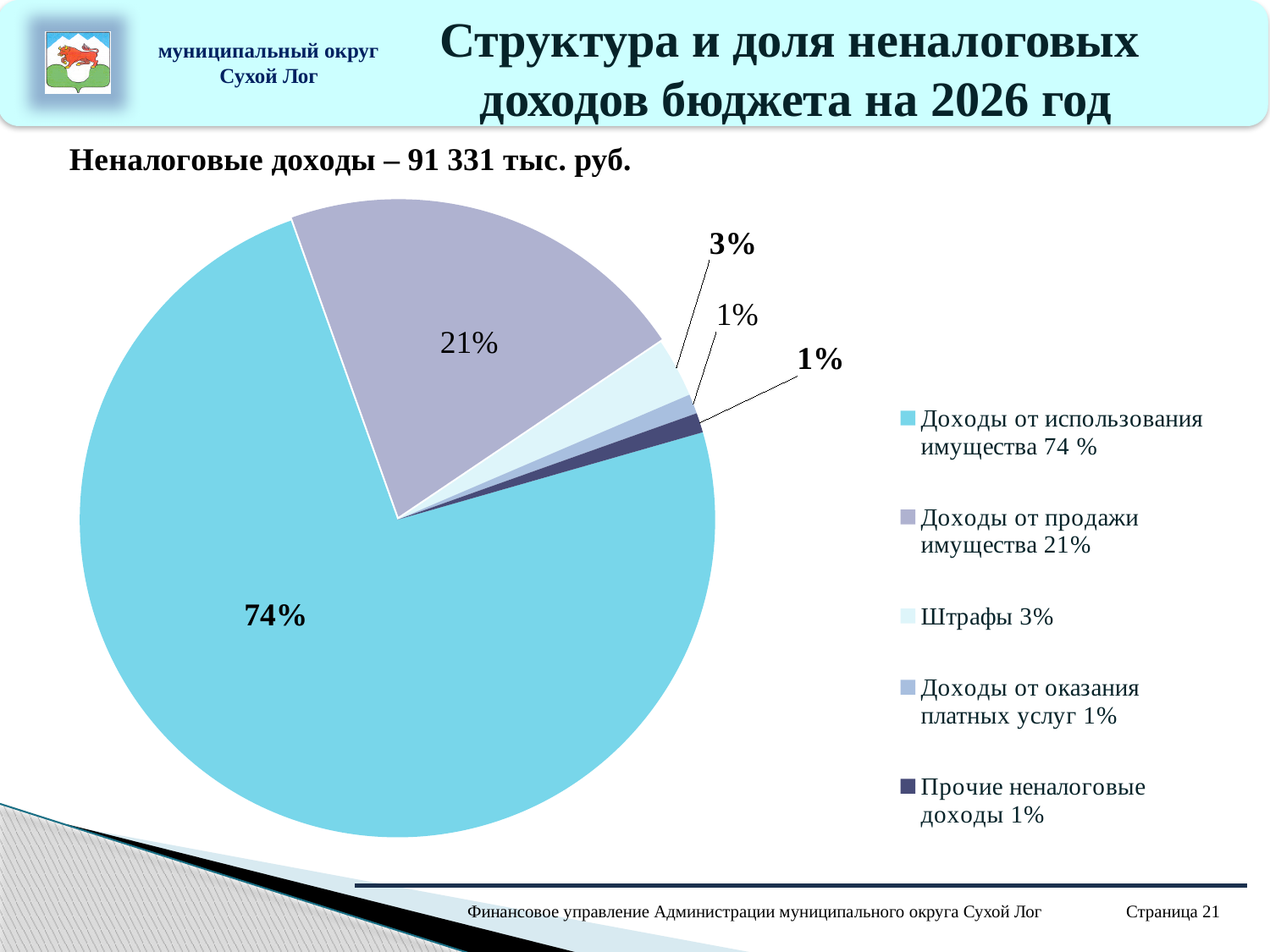
Which is larger, the slice for "Доходы от продажи имущества" or the slice for "Штрафы"? Доходы от продажи имущества What is the value shown for "Прочие неналоговые доходы"? 1% What is the value shown for "Доходы от продажи имущества"? 21% How many slices does the pie chart have? 5 What is the difference in percentage points between "Доходы от использования имущества" and "Доходы от продажи имущества"? 53 What kind of chart is shown on the slide? pie chart Which category has the largest slice of the pie? Доходы от использования имущества What total amount of non-tax revenue is stated above the chart? 91 331 тыс. руб. How many entries does the legend list? 5 What is the value shown for "Штрафы"? 3% What is the value shown for "Доходы от оказания платных услуг"? 1% What share of the pie does "Доходы от использования имущества" take? 74%